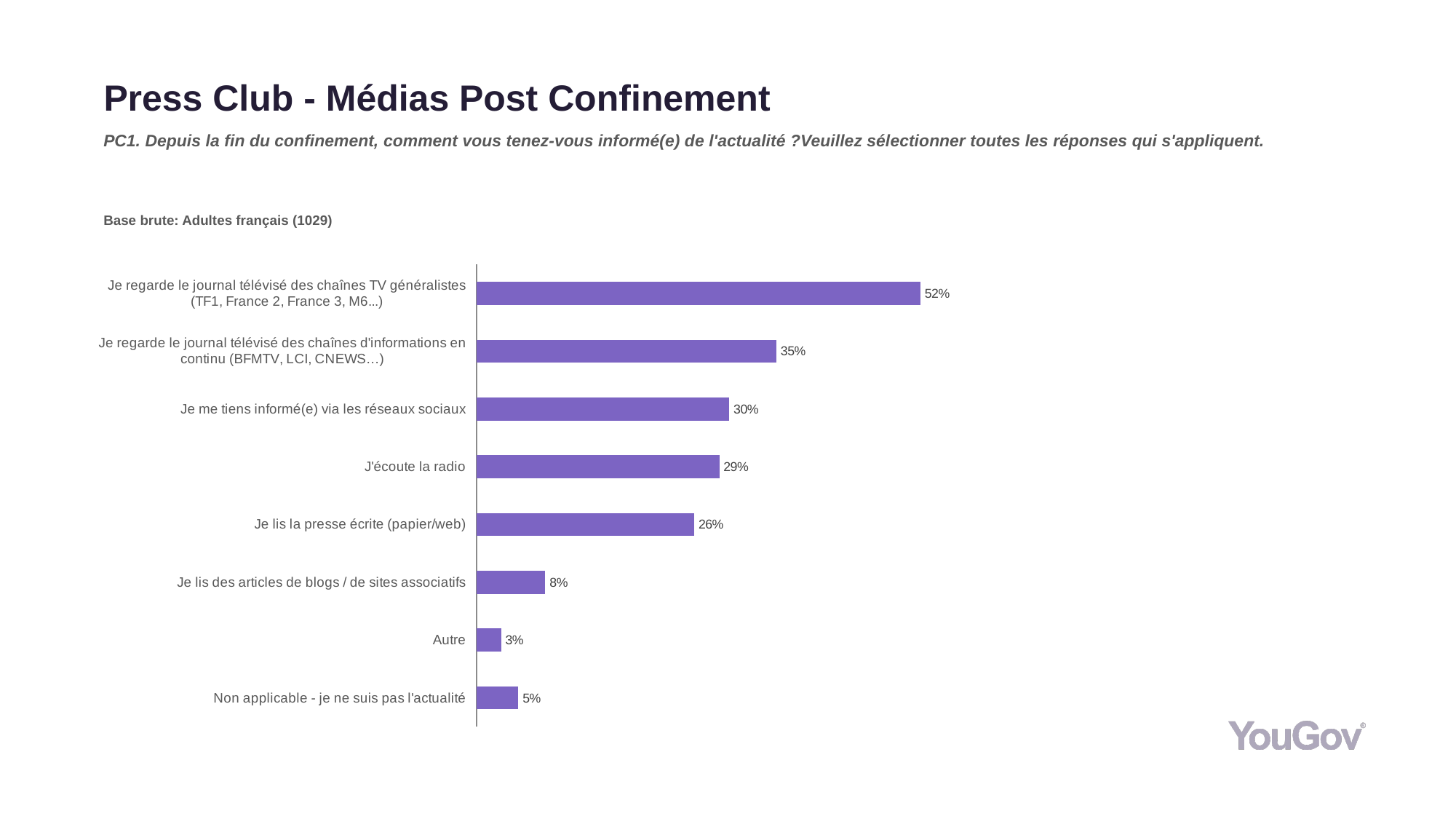
What is the difference between the values for "Autre" and "Non applicable - je ne suis pas l'actualité"? 2 percentage points What is the difference between the value for general TV channels news (52%) and continuous news channels (35%)? 17 percentage points Which category has the highest value? Je regarde le journal télévisé des chaînes TV généralistes (TF1, France 2, France 3, M6...) What type of chart is shown on the slide? Bar chart What percentage of respondents say they watch the TV news on general channels (TF1, France 2, France 3, M6...)? 52% Which is larger: the value for "Je me tiens informé(e) via les réseaux sociaux" or "Je lis la presse écrite (papier/web)"? Je me tiens informé(e) via les réseaux sociaux What is the base (sample size) stated on the slide? Adultes français (1029) What is the value for "J'écoute la radio"? 29% Which category has the lowest value? Autre How many categories are shown in the chart? 8 What percentage of respondents read blog articles / association websites? 8% What is the value for "Non applicable - je ne suis pas l'actualité"? 5%